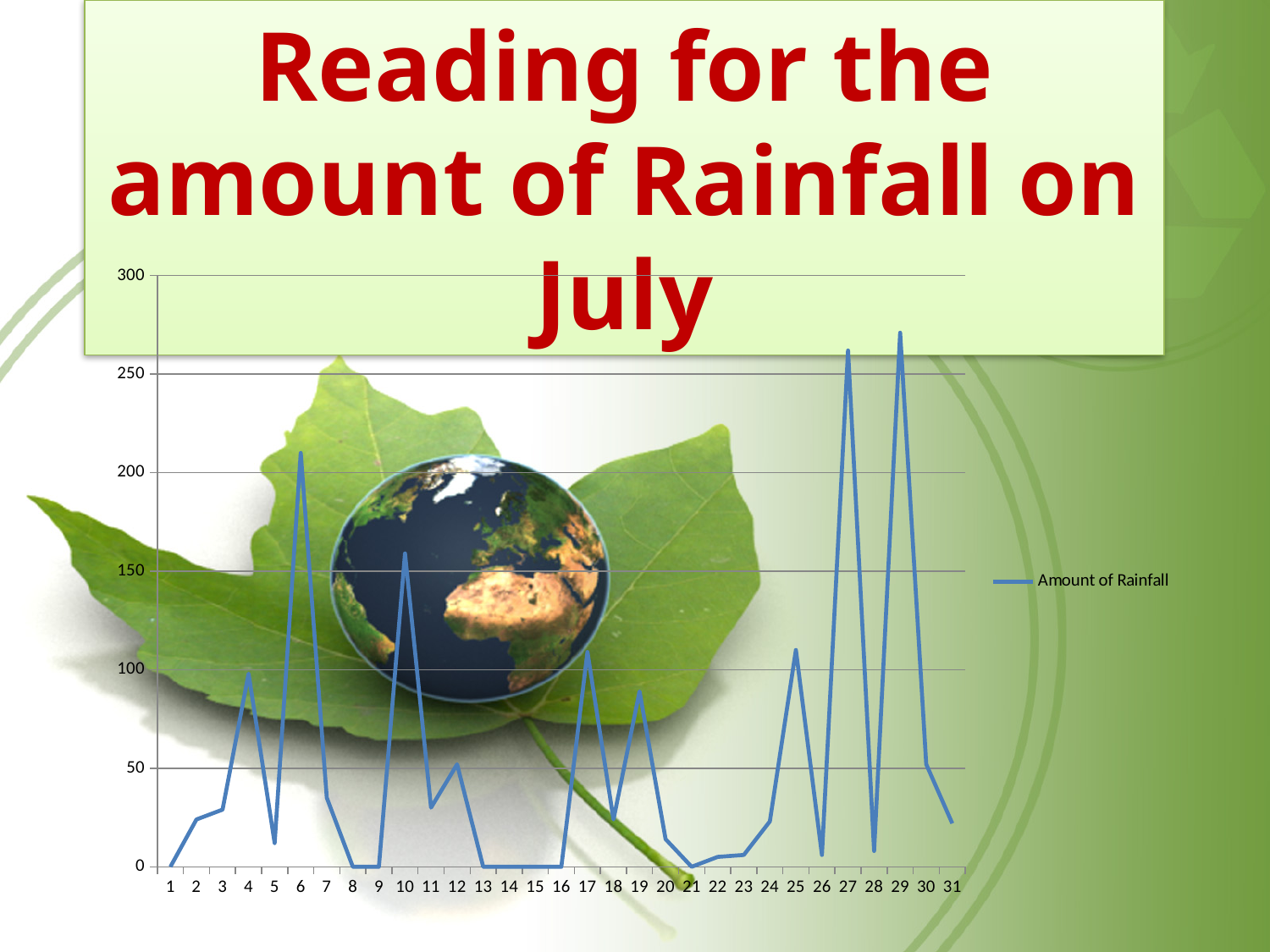
Is the value for day 27 greater or less than 250? greater What kind of chart is shown on the slide? line chart How many days are plotted along the x axis? 31 Which has the larger value, day 29 or day 30? day 29 Is the value for day 6 greater or less than 200? greater How many series does the legend list? 1 Is the value for day 19 greater or less than 100? less What is the title of the chart? Reading for the amount of Rainfall on July Which has the larger value, day 6 or day 10? day 6 What is the name of the series shown in the legend? Amount of Rainfall